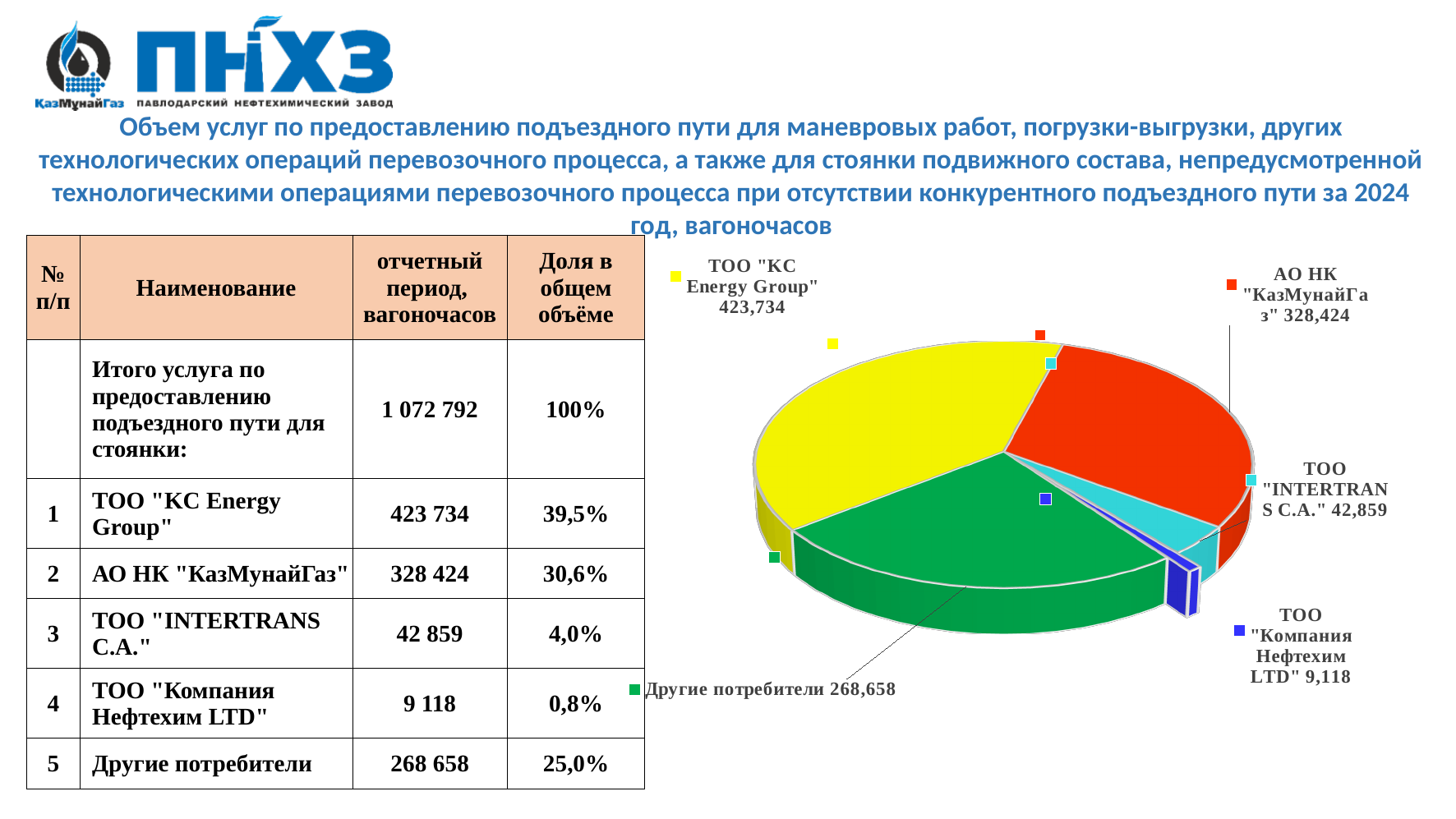
What is the value shown for ТОО "Компания Нефтехим LTD" in the pie chart? 9,118 What is the value shown for ТОО "INTERTRANS C.A." in the pie chart? 42,859 What colour is the slice for Другие потребители in the pie chart? green What is the difference between the values for ТОО "KC Energy Group" and АО НК "КазМунайГаз" in the pie chart? 95,310 What is the value shown for ТОО "KC Energy Group" in the pie chart? 423,734 What kind of chart is shown on the slide? pie chart What is the value shown for АО НК "КазМунайГаз" in the pie chart? 328,424 How many slices does the pie chart have? 5 Which slice of the pie chart is the largest? ТОО "KC Energy Group" What is the value shown for Другие потребители in the pie chart? 268,658 Which is larger in the pie chart: Другие потребители or ТОО "INTERTRANS C.A."? Другие потребители Which slice of the pie chart is the smallest? ТОО "Компания Нефтехим LTD"